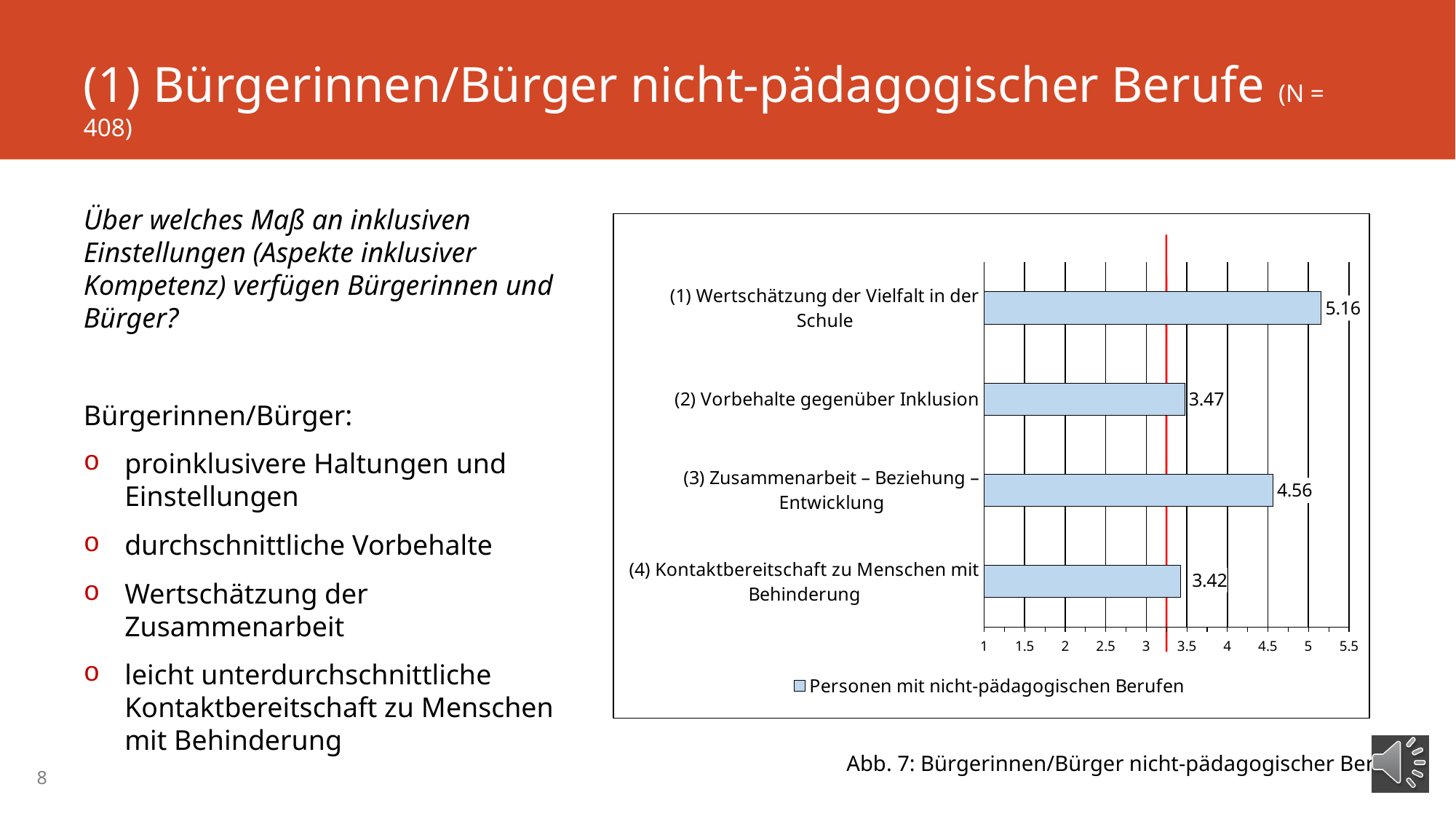
How many categories are shown in the chart? 4 What is the difference between the values for "(1) Wertschätzung der Vielfalt in der Schule" and "(3) Zusammenarbeit – Beziehung – Entwicklung"? 0.60 Is the value for "(1) Wertschätzung der Vielfalt in der Schule" greater or less than 5? greater Which category has the lowest value? (4) Kontaktbereitschaft zu Menschen mit Behinderung What series name does the chart legend show? Personen mit nicht-pädagogischen Berufen Which category has the highest value? (1) Wertschätzung der Vielfalt in der Schule What kind of chart is shown on the slide? Bar chart What is the value for "(3) Zusammenarbeit – Beziehung – Entwicklung"? 4.56 What is the value for "(4) Kontaktbereitschaft zu Menschen mit Behinderung"? 3.42 What is the value for "(1) Wertschätzung der Vielfalt in der Schule"? 5.16 What is the value for "(2) Vorbehalte gegenüber Inklusion"? 3.47 Which is larger: the value for "(2) Vorbehalte gegenüber Inklusion" or the value for "(3) Zusammenarbeit – Beziehung – Entwicklung"? (3) Zusammenarbeit – Beziehung – Entwicklung